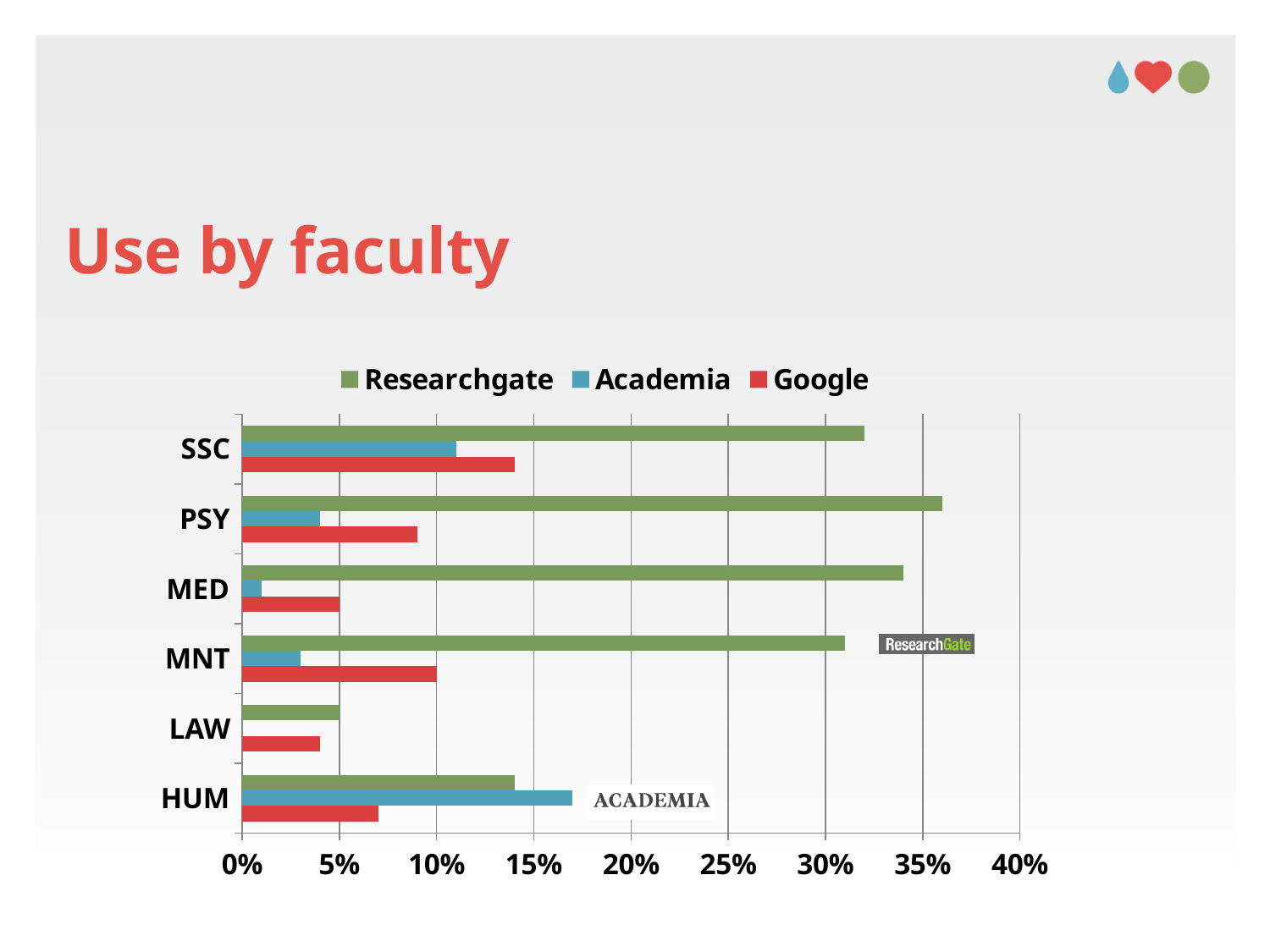
Is the Academia value for HUM greater or less than 15%? greater Is the Academia value for MED greater or less than 5%? less Which faculty has the highest Researchgate value? PSY Is the Researchgate value for SSC greater or less than 30%? greater How many series does the legend list? 3 What kind of chart is shown on the slide? bar chart Which faculty has the lowest Researchgate value? LAW How many faculties are shown on the chart? 6 For HUM, which is larger: the Academia value or the Researchgate value? Academia Which faculty has no Academia bar on the chart? LAW Which is larger: the Google value for SSC or the Google value for PSY? SSC Which faculty has the highest Academia value? HUM